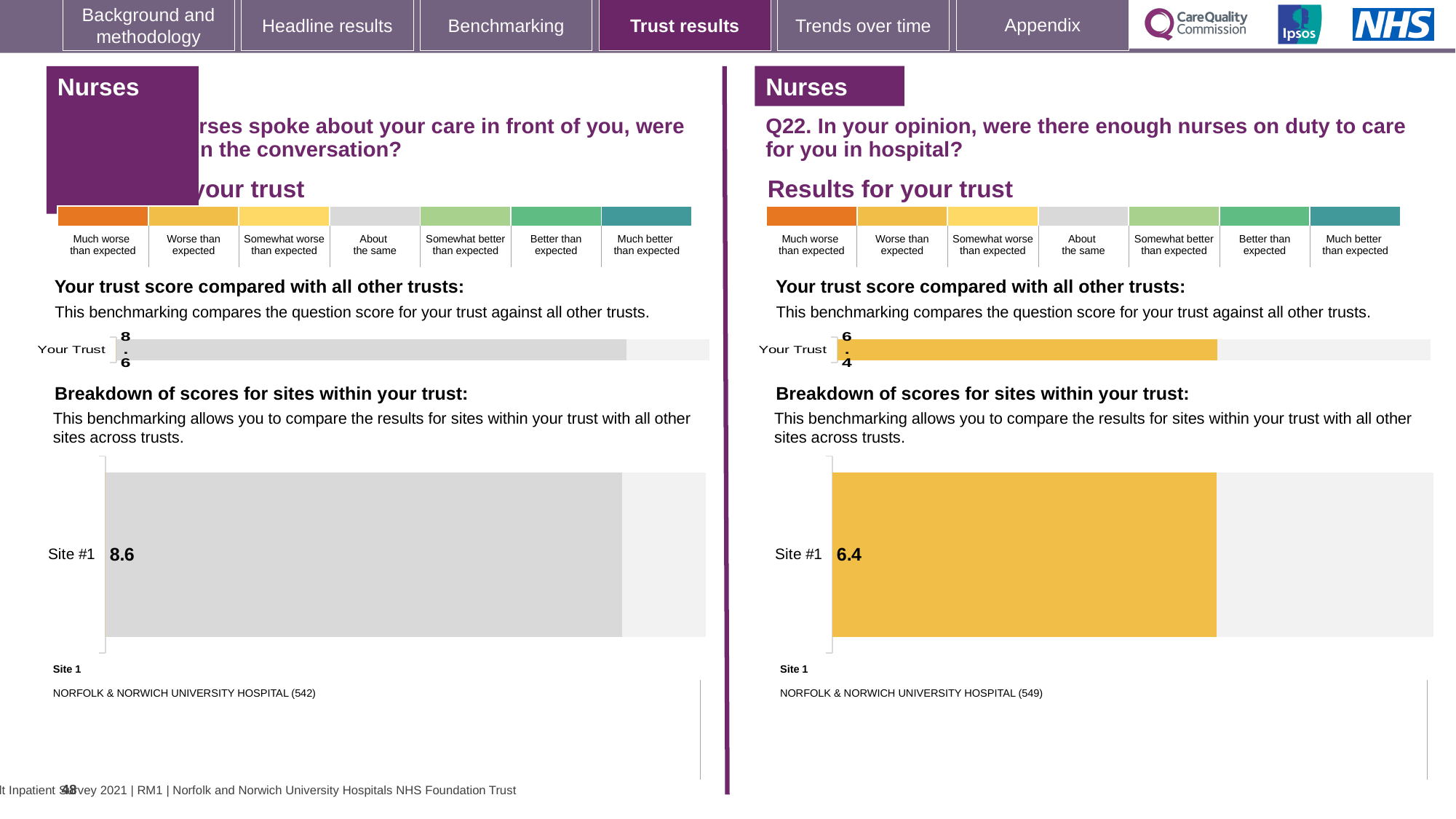
What kind of chart is used to show the Site #1 score on the right half of the slide (Q22)? Bar chart Which is larger: the Site #1 score on the left half of the slide or the Site #1 score on the right half (Q22)? Left half (8.6) What is the difference between the Site #1 score on the left half of the slide (8.6) and the Site #1 score on the right half (6.4)? 2.2 On the right half of the slide (Q22), what is the score shown for Site #1 in the breakdown of scores for sites within your trust? 6.4 How many sites are shown in the breakdown of scores chart on the right half of the slide (Q22)? 1 On the right half of the slide (Q22), which benchmark category does the yellow colour of the Site #1 bar correspond to in the colour key? Worse than expected On the right half of the slide (Q22), which site name is listed as Site 1 below the chart? NORFOLK & NORWICH UNIVERSITY HOSPITAL (549) On the left half of the slide, what is the 'Your Trust' score in the chart comparing the trust score with all other trusts? 8.6 How many sites are shown in the breakdown of scores chart on the left half of the slide? 1 On the left half of the slide, what is the score shown for Site #1 in the breakdown of scores for sites within your trust? 8.6 On the left half of the slide, which benchmark category does the grey colour of the Site #1 bar correspond to in the colour key? About the same On the right half of the slide (Q22), what is the 'Your Trust' score in the chart comparing the trust score with all other trusts? 6.4